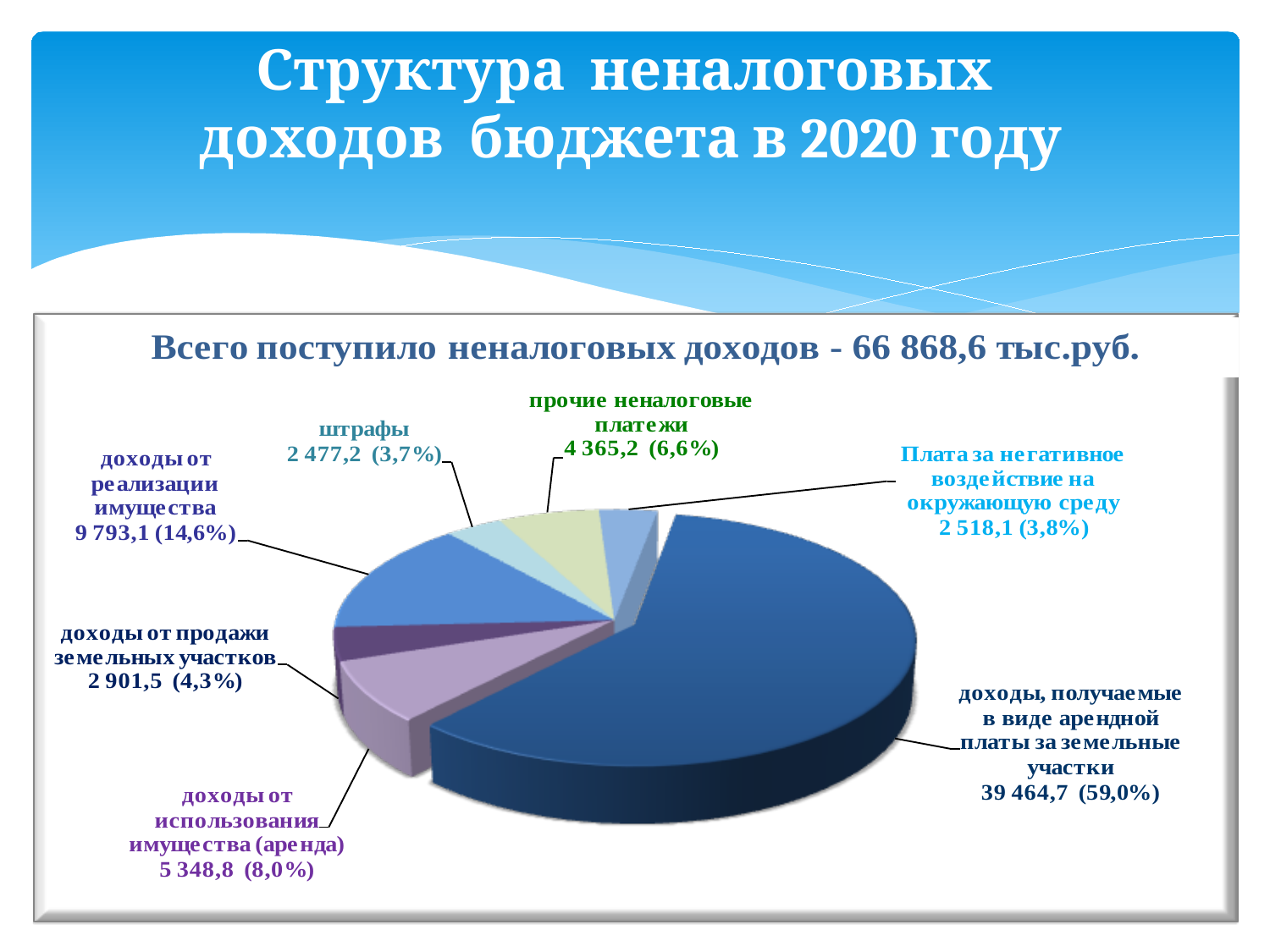
What is the difference in percentage share between «Плата за негативное воздействие на окружающую среду» and «штрафы»? 0,1% Which category has the largest slice of the pie? доходы, получаемые в виде арендной платы за земельные участки What is the value for «штрафы»? 2 477,2 (3,7%) Which is larger: «доходы от продажи земельных участков» or «доходы от использования имущества (аренда)»? доходы от использования имущества (аренда) What is the title of the slide? Структура неналоговых доходов бюджета в 2020 году What kind of chart is shown on the slide? Pie chart What is the value for «доходы, получаемые в виде арендной платы за земельные участки»? 39 464,7 (59,0%) What total amount of non-tax revenue is stated on the slide? 66 868,6 тыс.руб. What share of the pie does «доходы от реализации имущества» represent? 14,6% How many slices does the pie chart have? 7 Which category has the smallest slice of the pie? штрафы What is the value for «прочие неналоговые платежи»? 4 365,2 (6,6%)